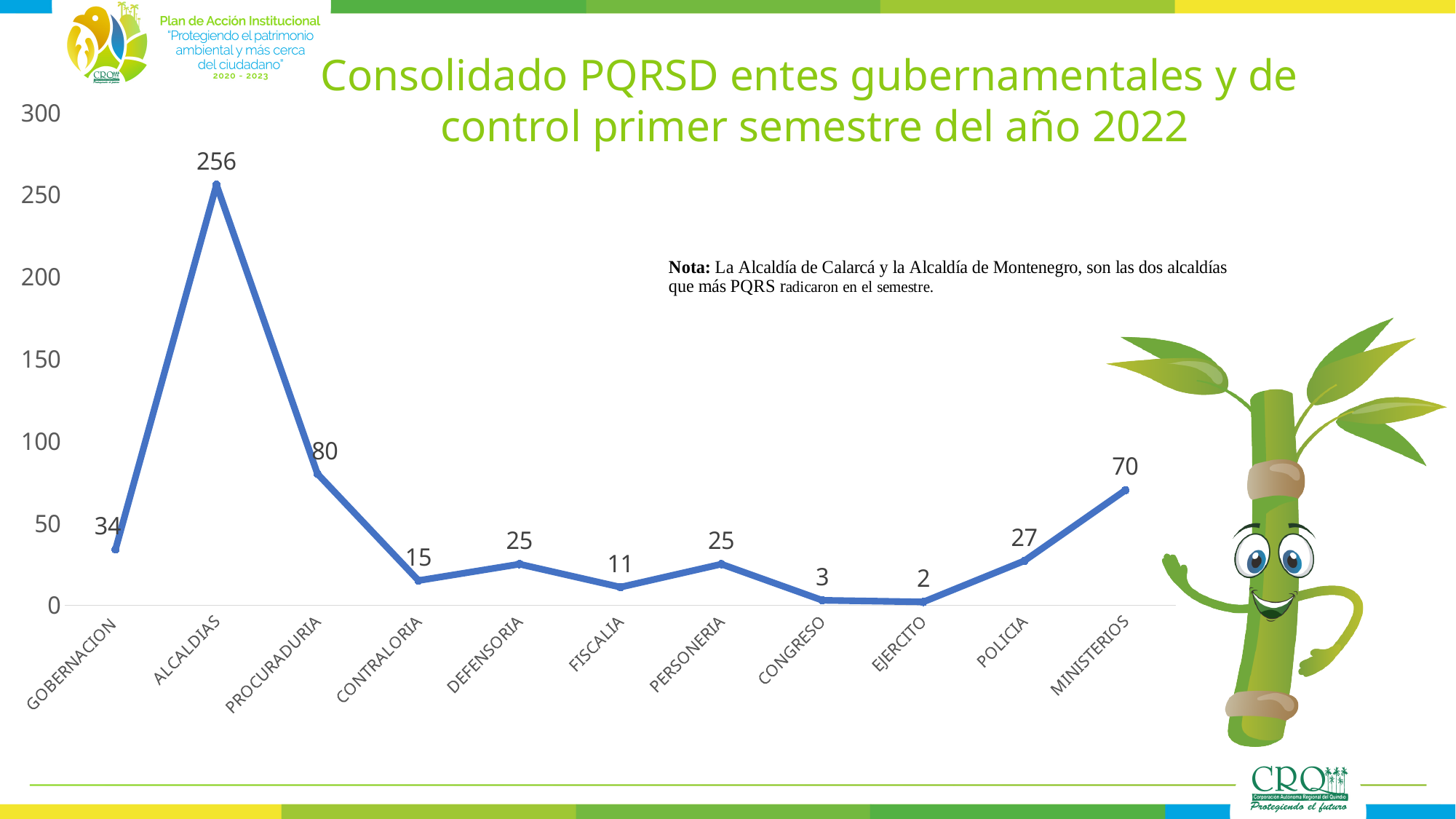
What is the value for MINISTERIOS? 70 What is the title of the chart? Consolidado PQRSD entes gubernamentales y de control primer semestre del año 2022 What is the difference between the values for ALCALDIAS and PROCURADURIA? 176 What kind of chart is shown on the slide? line chart Which is larger, the value for GOBERNACION or the value for POLICIA? GOBERNACION Is the value for ALCALDIAS greater or less than 250? greater How many categories are shown on the x axis? 11 Which category has the lowest value? EJERCITO What is the value for EJERCITO? 2 What is the value for ALCALDIAS? 256 What is the value for PROCURADURIA? 80 Which category has the highest value? ALCALDIAS